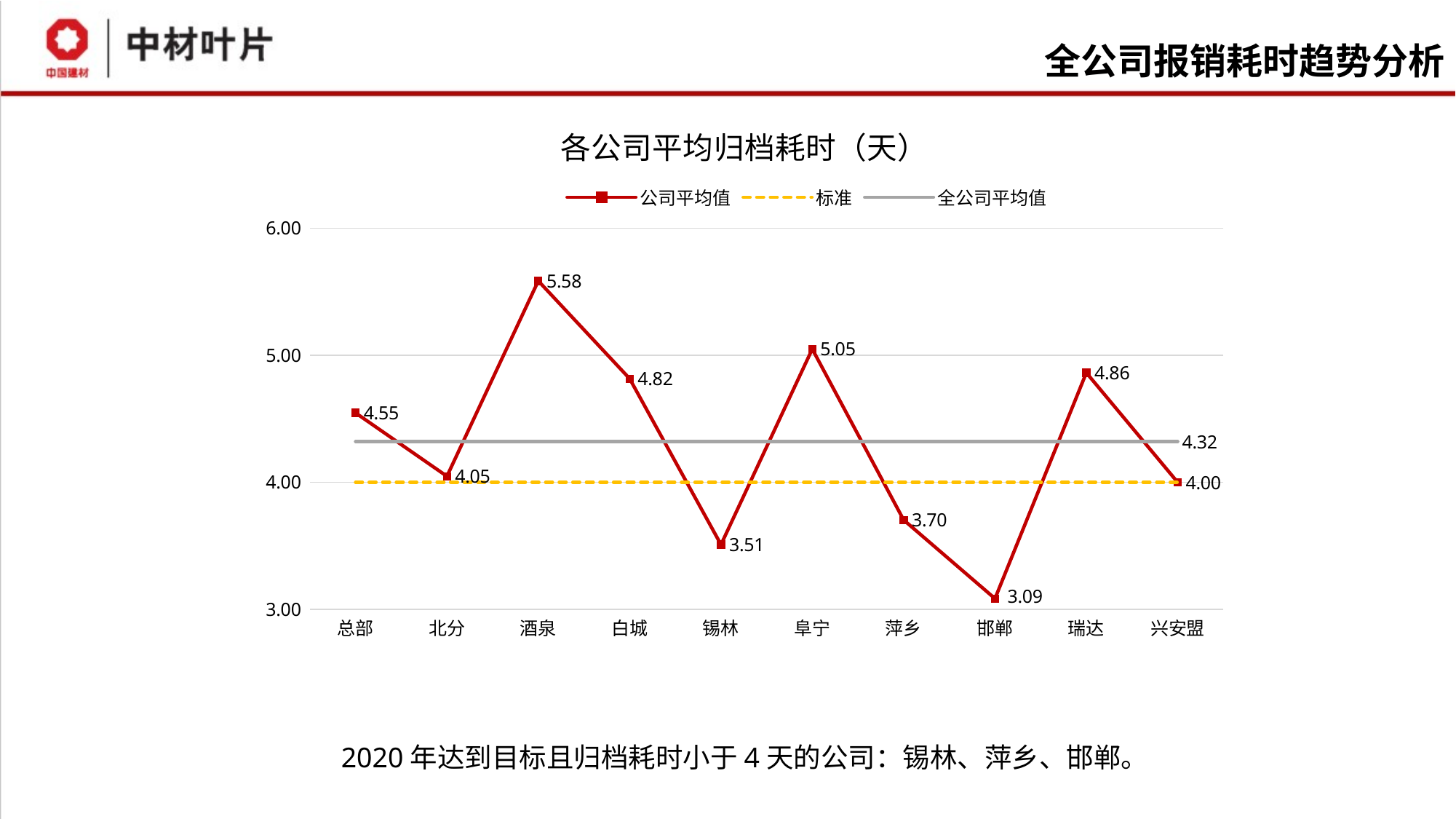
What is the 公司平均值 for 邯郸? 3.09 What is the 公司平均值 for 总部? 4.55 What is the value of the 全公司平均值 line? 4.32 How many companies are shown on the x axis? 10 What is the value of the 标准 line? 4.00 What is the 公司平均值 for 酒泉? 5.58 Which has a higher 公司平均值, 阜宁 or 瑞达? 阜宁 What is the difference between the 公司平均值 for 酒泉 and 邯郸? 2.49 Which company has the highest 公司平均值? 酒泉 What kind of chart is this? Line chart How many series does the legend list? 3 Which company has the lowest 公司平均值? 邯郸